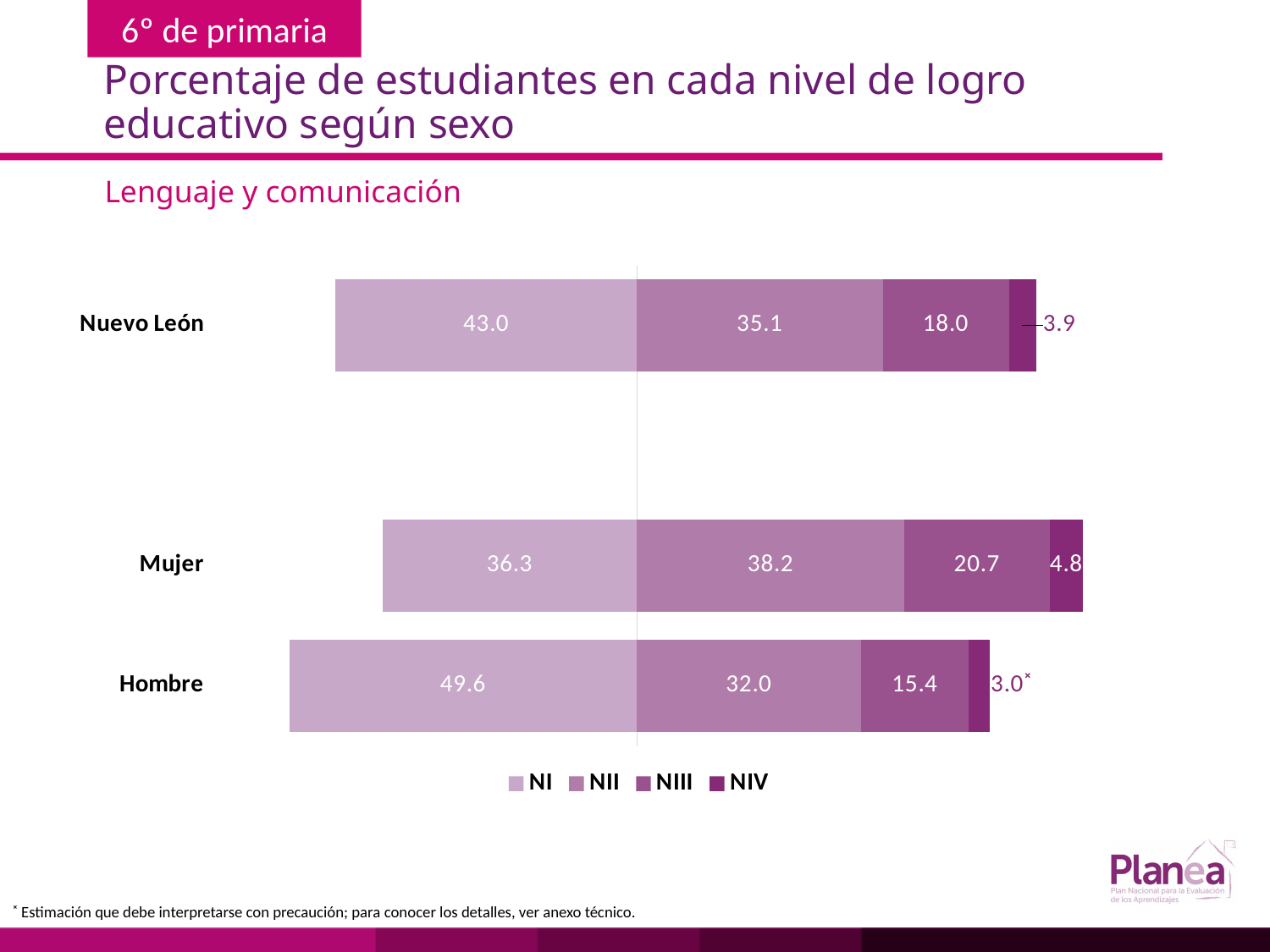
What is the total of the stacked bar for Nuevo León? 100.0 How many series does the legend list? 4 What is the NII value for Mujer? 38.2 What kind of chart is shown on the slide? Stacked bar chart How many categories are shown on the chart? 3 Which category has the highest NI value? Hombre Which is larger, the NIII value for Mujer or the NIII value for Hombre? Mujer What is the NIV value for Mujer? 4.8 What is the difference between the NI values for Hombre and Mujer? 13.3 What is the NI value for Hombre? 49.6 What is the NIII value for Nuevo León? 18.0 Which category has the lowest NIV value? Hombre